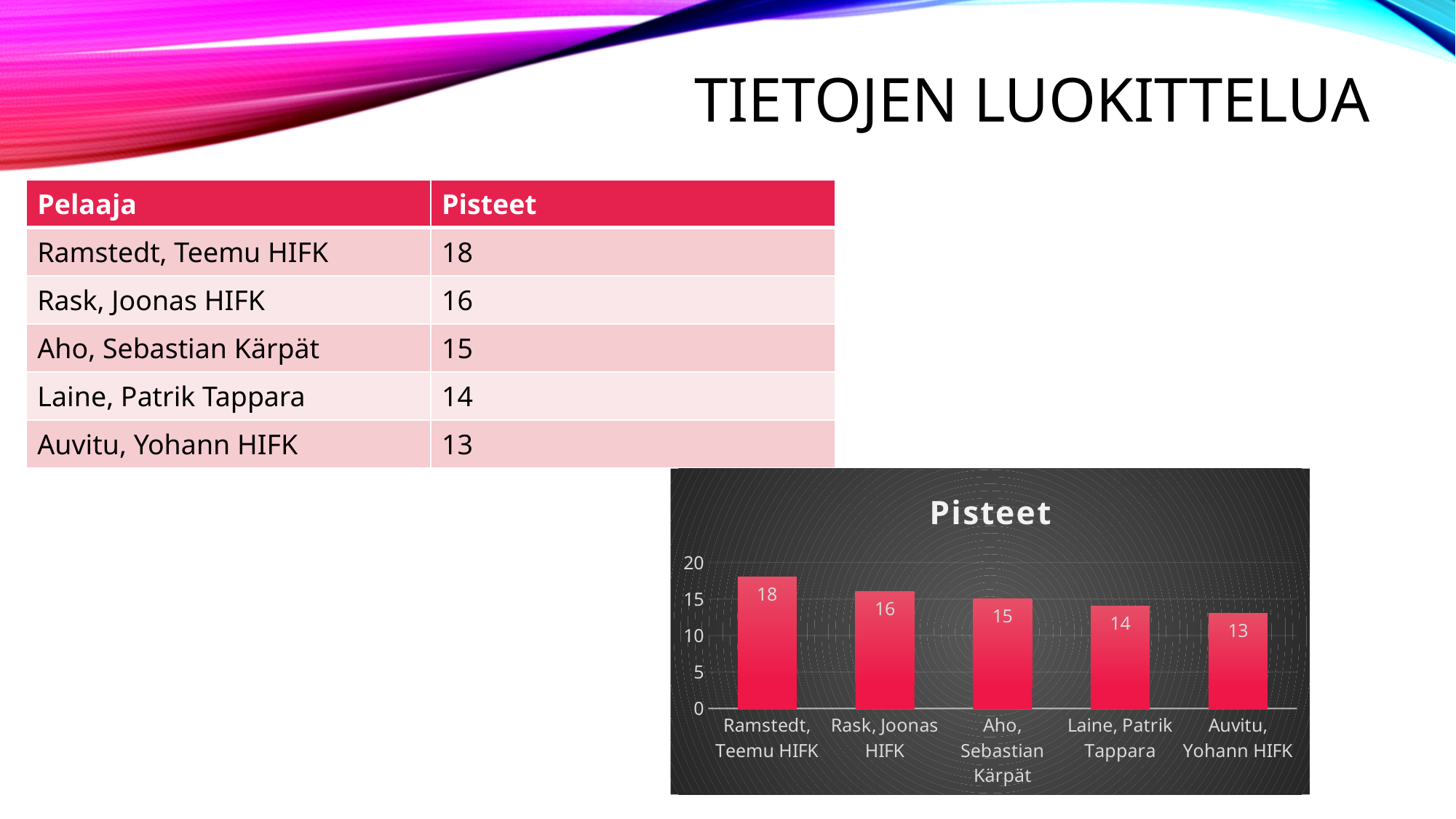
In the Pisteet chart, which is larger: the value for Rask, Joonas HIFK or the value for Auvitu, Yohann HIFK? Rask, Joonas HIFK What is the value for Auvitu, Yohann HIFK in the Pisteet chart? 13 Which player has the lowest value in the Pisteet chart? Auvitu, Yohann HIFK What kind of chart is the Pisteet chart? bar chart What is the difference between the values for Ramstedt, Teemu HIFK and Laine, Patrik Tappara in the Pisteet chart? 4 Do the values in the Pisteet chart rise or fall from left to right? fall What is the value for Ramstedt, Teemu HIFK in the Pisteet chart? 18 Which player has the highest value in the Pisteet chart? Ramstedt, Teemu HIFK What is the title of the chart on the slide? Pisteet How many players are shown in the Pisteet chart? 5 Is the value for Laine, Patrik Tappara in the Pisteet chart greater or less than 10? greater What is the value for Aho, Sebastian Kärpät in the Pisteet chart? 15